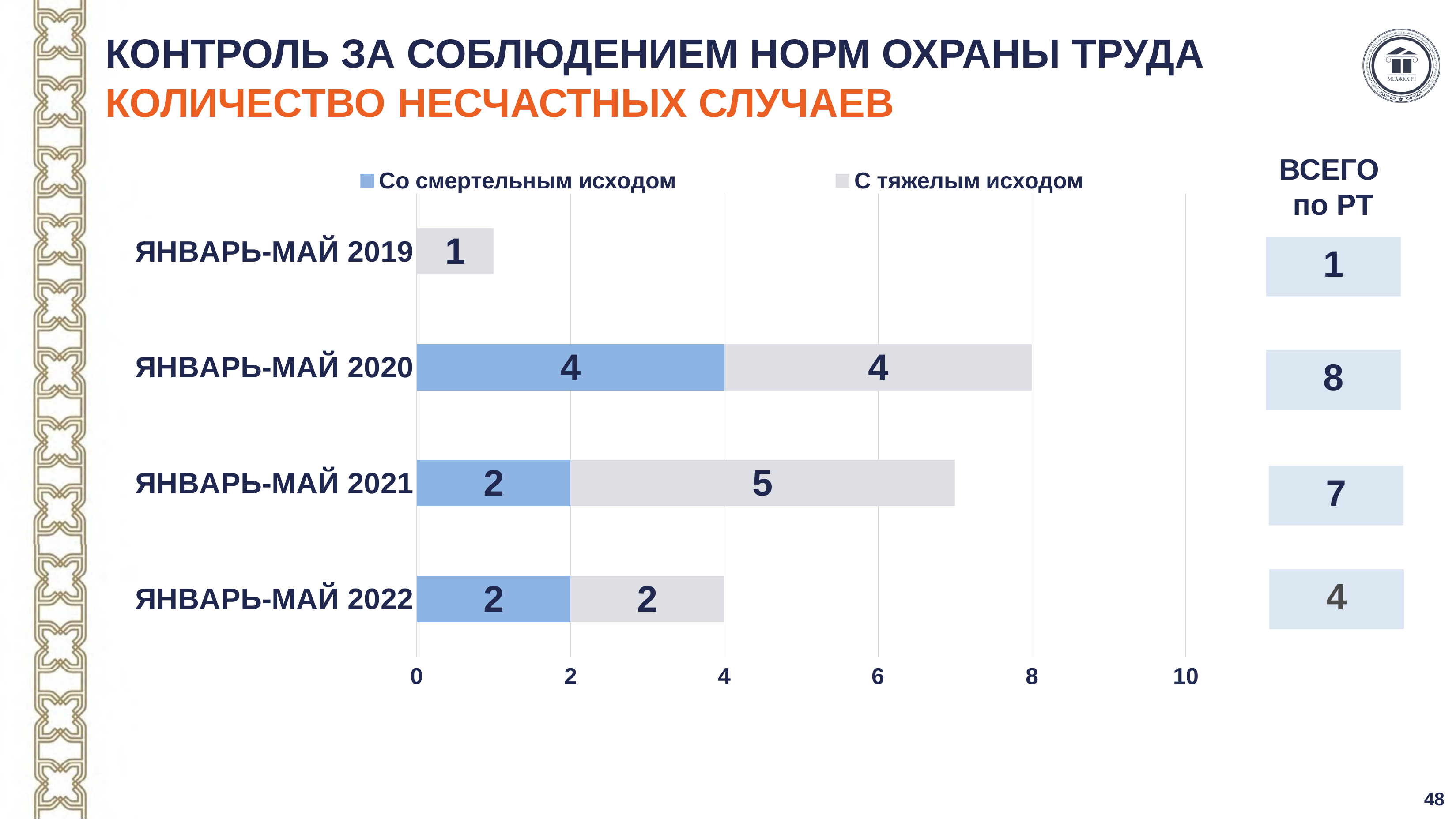
What is the difference between the 'С тяжелым исходом' values for ЯНВАРЬ-МАЙ 2021 and ЯНВАРЬ-МАЙ 2022? 3 Which period has the highest total number of accidents? ЯНВАРЬ-МАЙ 2020 Which is larger: the 'Со смертельным исходом' value for ЯНВАРЬ-МАЙ 2020 or for ЯНВАРЬ-МАЙ 2021? ЯНВАРЬ-МАЙ 2020 What is the value for 'С тяжелым исходом' in ЯНВАРЬ-МАЙ 2019? 1 What is the total of the stacked bar for ЯНВАРЬ-МАЙ 2022? 4 Which period has the lowest total number of accidents? ЯНВАРЬ-МАЙ 2019 How many categories (periods) are shown on the chart? 4 Which series is shown in blue in the legend? Со смертельным исходом How many series does the legend list? 2 What kind of chart is shown on the slide? Stacked bar chart What is the value for 'С тяжелым исходом' in ЯНВАРЬ-МАЙ 2021? 5 What is the value for 'Со смертельным исходом' in ЯНВАРЬ-МАЙ 2020? 4